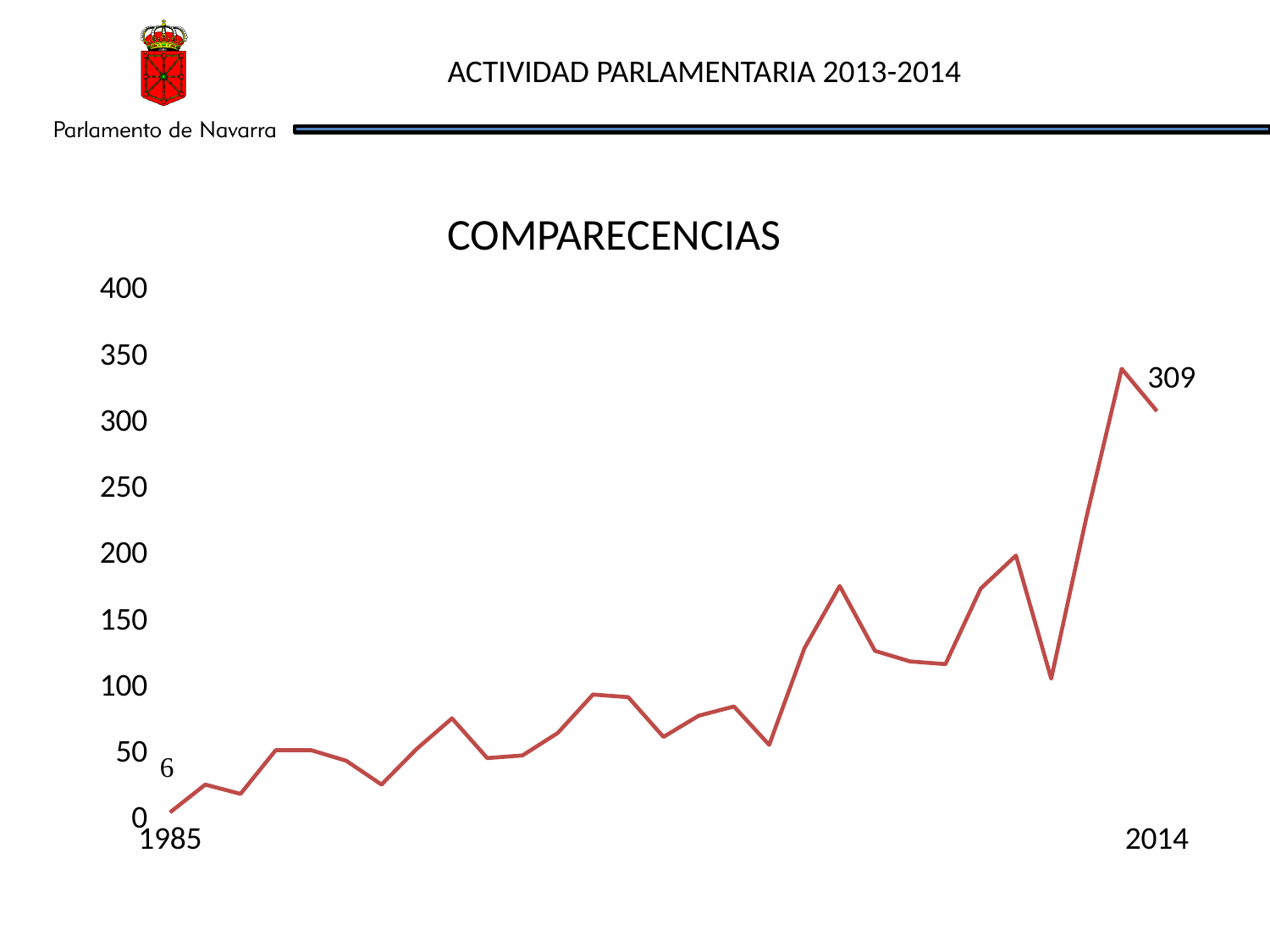
What is the value for 2014? 309 What kind of chart is shown on the slide? line chart Which year has the larger value, 1985 or 2014? 2014 What is the first year shown on the horizontal axis? 1985 Overall, do the values rise or fall from 1985 to 2014? rise What is the title of the chart? COMPARECENCIAS What is the last year shown on the horizontal axis? 2014 What is the value for 1985? 6 Is the highest point on the line greater or less than 300? greater What is the highest value shown on the vertical axis? 400 What is the difference between the value for 2014 and the value for 1985? 303 Is the value for 1985 greater or less than 50? less